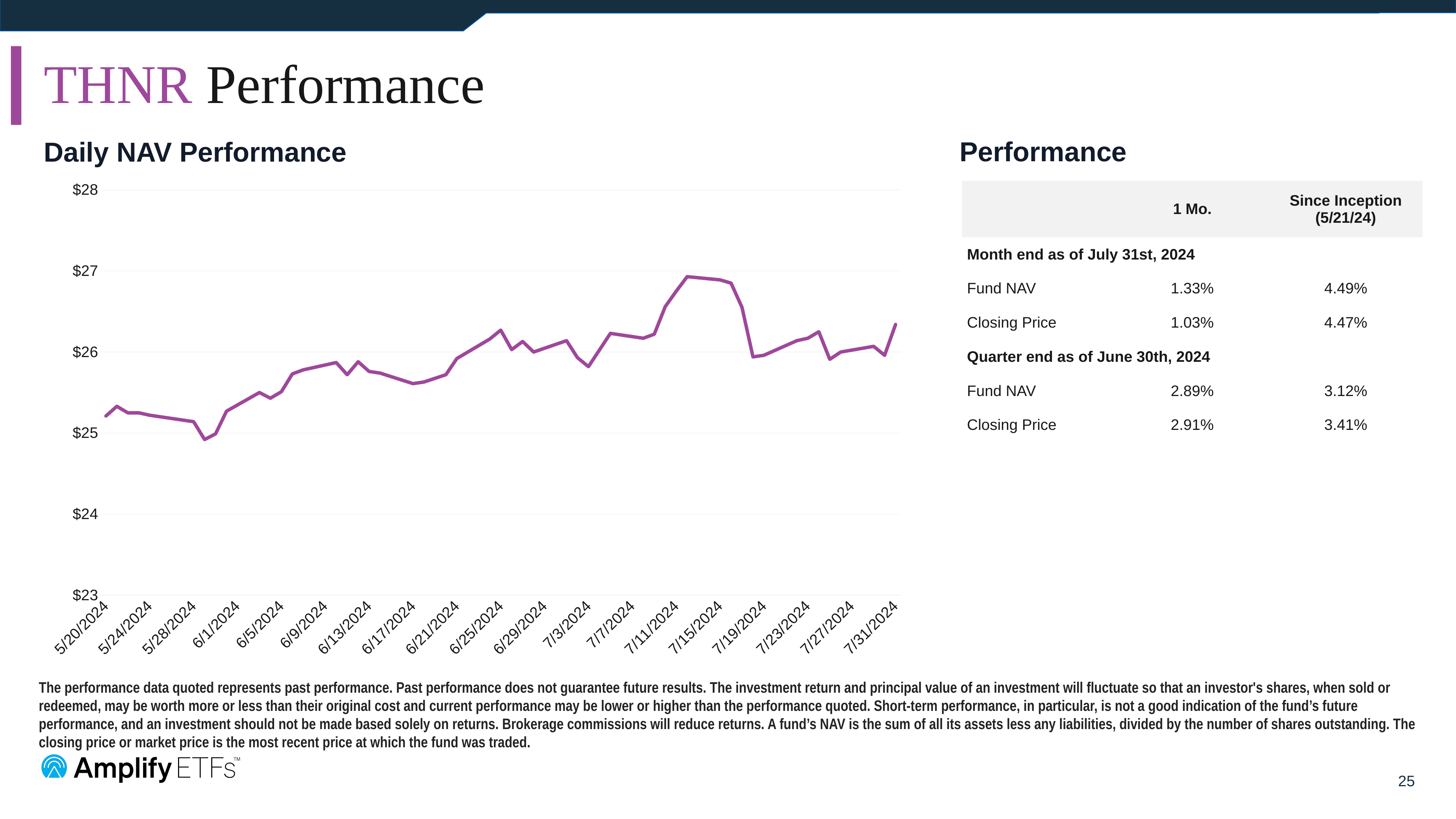
In the Daily NAV Performance chart, does the NAV overall rise or fall from 5/20/2024 to 7/31/2024? rise In the Daily NAV Performance chart, is the value for 7/11/2024 greater or less than $26? greater In the Daily NAV Performance chart, is the value for 7/31/2024 greater or less than $26? greater In the Daily NAV Performance chart, is the value for 6/17/2024 greater or less than $26? less What kind of chart is the Daily NAV Performance chart? line chart How many lines are plotted in the Daily NAV Performance chart? 1 What is the title of the chart on the left of the slide? Daily NAV Performance What colour is the line in the Daily NAV Performance chart? purple In the Daily NAV Performance chart, is the value on 7/11/2024 larger or smaller than the value on 5/20/2024? larger